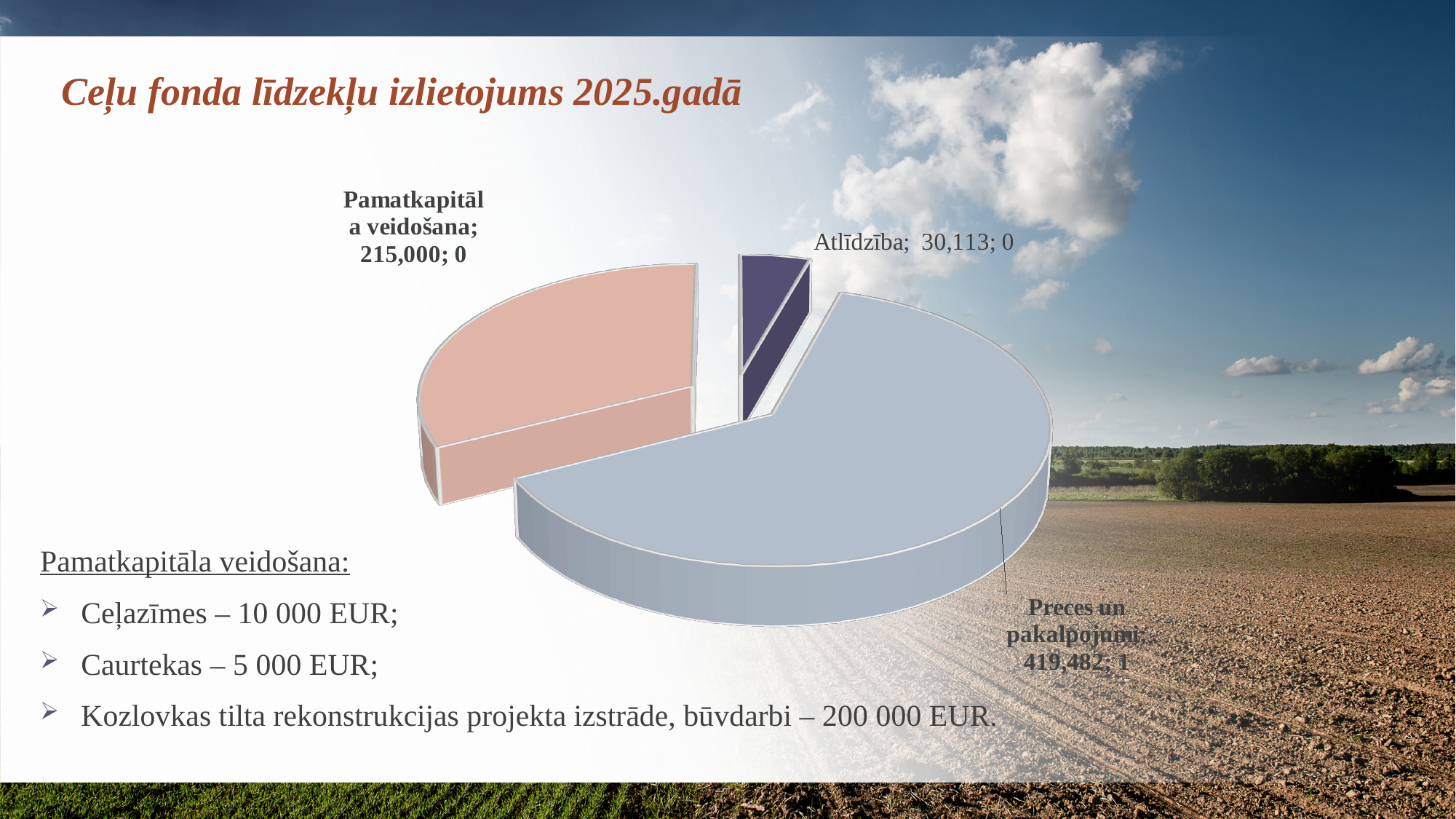
What value is shown for the Atlīdzība slice? 30,113 What value is shown for the Preces un pakalpojumi slice? 419,482 What type of chart is shown on the slide? Pie chart What is the title of the slide containing the chart? Ceļu fonda līdzekļu izlietojums 2025.gadā Which is larger, the value for Pamatkapitāla veidošana or the value for Atlīdzība? Pamatkapitāla veidošana Which category has the largest slice of the pie? Preces un pakalpojumi How many slices does the pie chart have? 3 Which category has the smallest slice of the pie? Atlīdzība What is the difference between the values for Preces un pakalpojumi and Pamatkapitāla veidošana? 204,482 Which is larger, the value for Preces un pakalpojumi or the value for Pamatkapitāla veidošana? Preces un pakalpojumi What is the difference between the values for Pamatkapitāla veidošana and Atlīdzība? 184,887 What value is shown for the Pamatkapitāla veidošana slice? 215,000